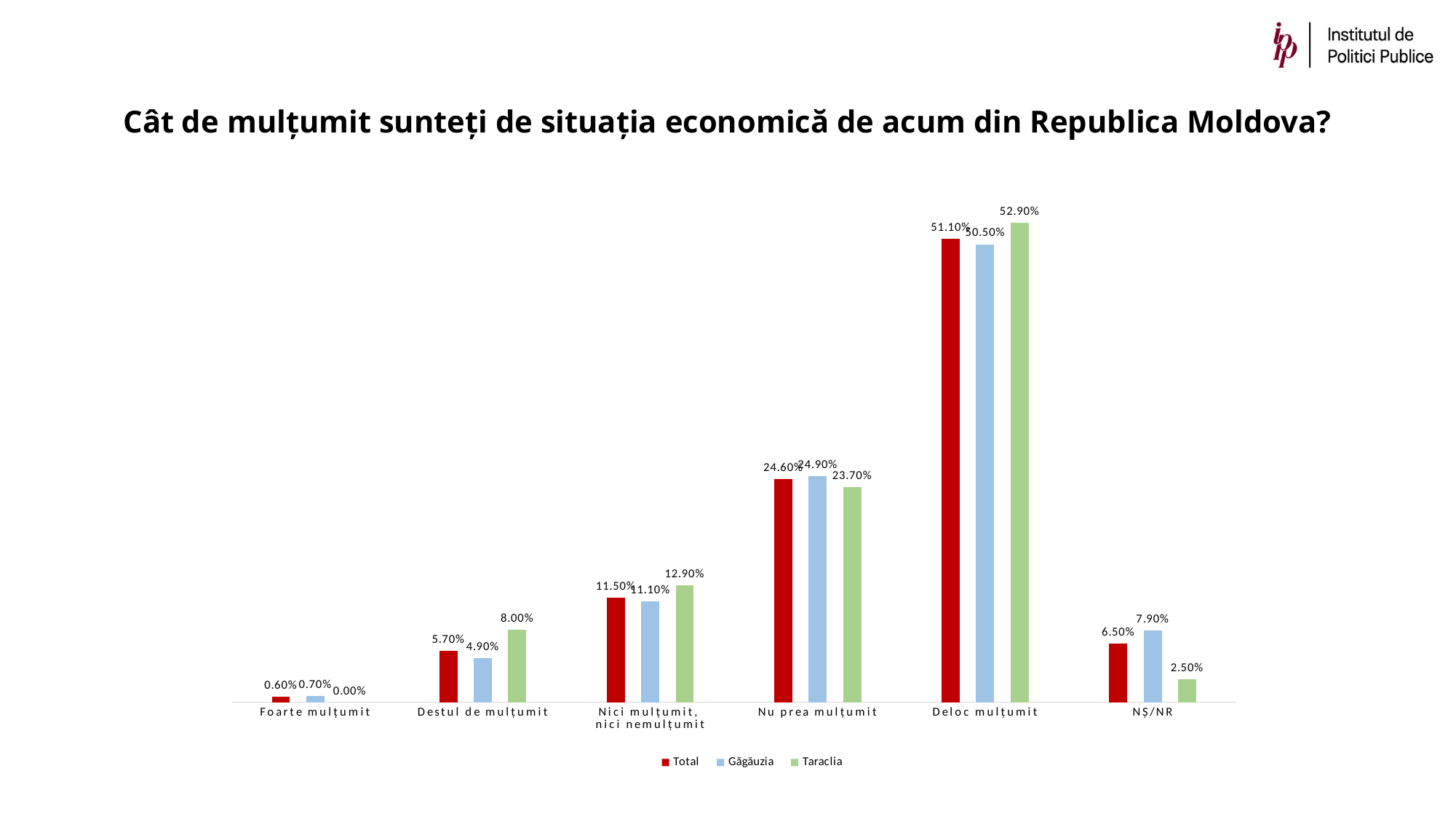
What is the Total value for "Deloc mulțumit"? 51.10% What is the Găgăuzia value for "NȘ/NR"? 7.90% What is the Taraclia value for "Destul de mulțumit"? 8.00% What is the Taraclia value for "Foarte mulțumit"? 0.00% What is the difference between the Taraclia and Total values for "Deloc mulțumit"? 1.80% What is the difference between the Găgăuzia and Taraclia values for "NȘ/NR"? 5.40% What kind of chart is shown on the slide? Bar chart Which category has the highest Taraclia value? Deloc mulțumit For "Destul de mulțumit", which is larger: the Total value or the Taraclia value? Taraclia How many categories are shown on the x axis? 6 Which category has the lowest Total value? Foarte mulțumit How many series does the legend list? 3